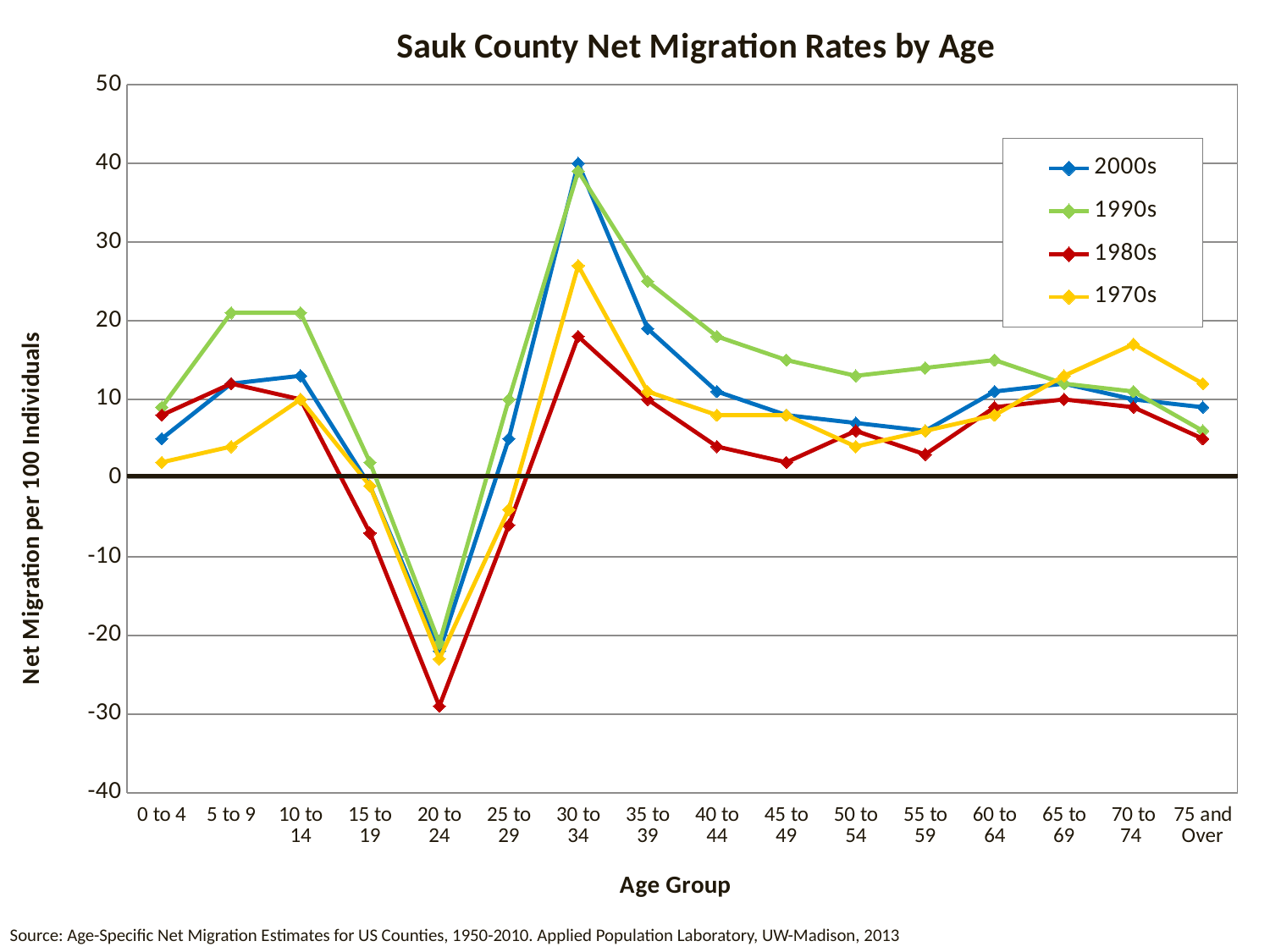
What kind of chart is shown on the slide? Line chart What is the title of the chart? Sauk County Net Migration Rates by Age Which series has the lowest value at age group 20 to 24? 1980s How many age groups are shown on the x axis? 16 Is the value for the 1980s series at age group 20 to 24 greater or less than -20? less Is the value for the 1970s series at age group 30 to 34 greater or less than 20? greater For the 1980s series, which age group has the lowest net migration rate? 20 to 24 For the 2000s series, which age group has the highest net migration rate? 30 to 34 How many series does the legend list? 4 At age group 70 to 74, which series has the larger value: 1970s or 1980s? 1970s At age group 30 to 34, which series has the larger value: 2000s or 1980s? 2000s Do the values for the 1990s series rise or fall from age group 30 to 34 to age group 50 to 54? fall